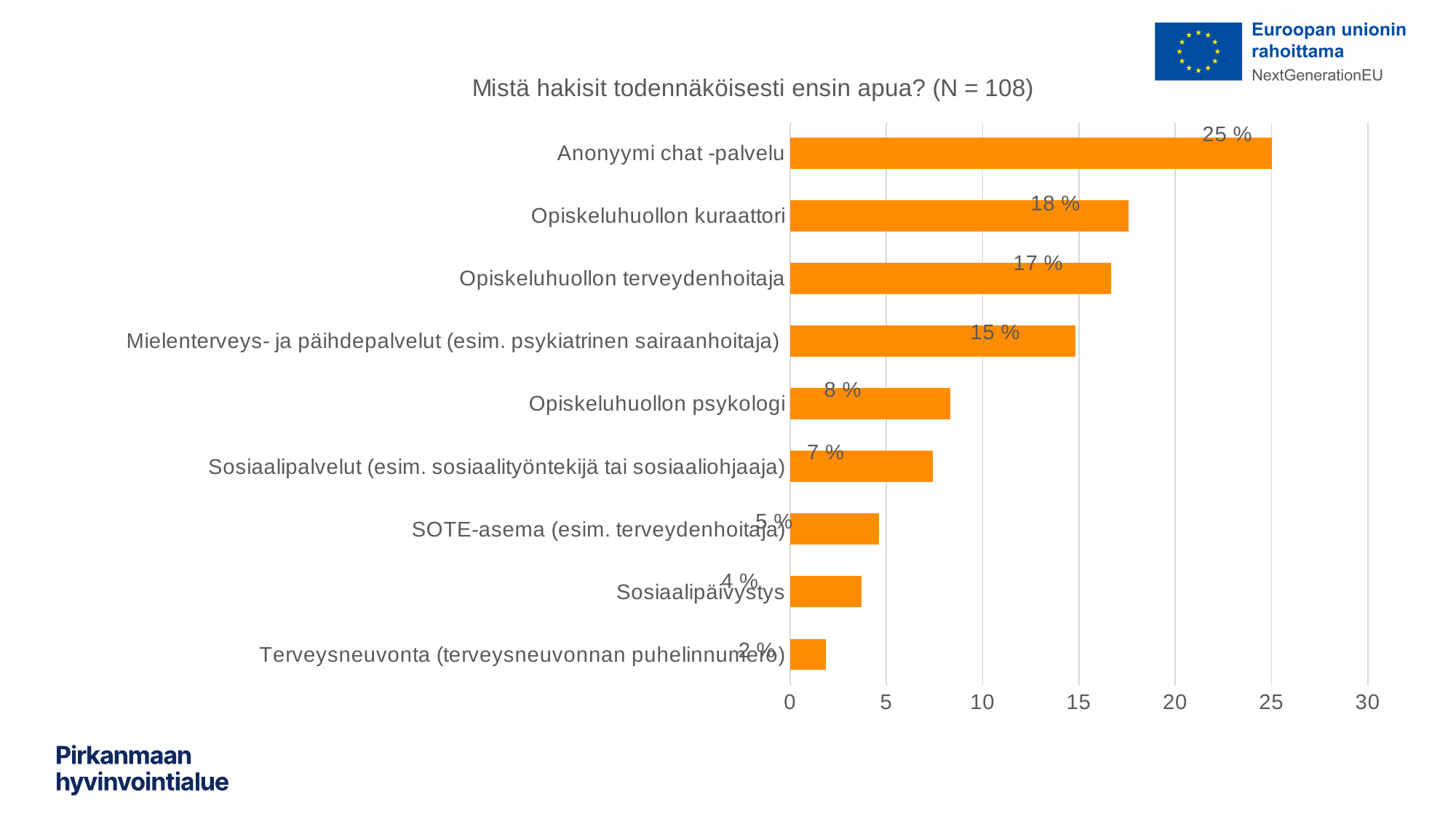
Is the value for Sosiaalipalvelut (esim. sosiaalityöntekijä tai sosiaaliohjaaja) greater or less than 10? less Which category has the highest value? Anonyymi chat -palvelu What kind of chart is shown on the slide? bar chart What is the value for Opiskeluhuollon kuraattori? 18 % How many categories are shown in the chart? 9 What is the title of the chart? Mistä hakisit todennäköisesti ensin apua? (N = 108) What is the difference between the values for Anonyymi chat -palvelu and Opiskeluhuollon kuraattori? 7 % What is the value for Opiskeluhuollon psykologi? 8 % Which category has the lowest value? Terveysneuvonta (terveysneuvonnan puhelinnumero) What is the value for Terveysneuvonta (terveysneuvonnan puhelinnumero)? 2 % Which is larger, the value for Opiskeluhuollon terveydenhoitaja or the value for Mielenterveys- ja päihdepalvelut (esim. psykiatrinen sairaanhoitaja)? Opiskeluhuollon terveydenhoitaja What is the value for Anonyymi chat -palvelu? 25 %